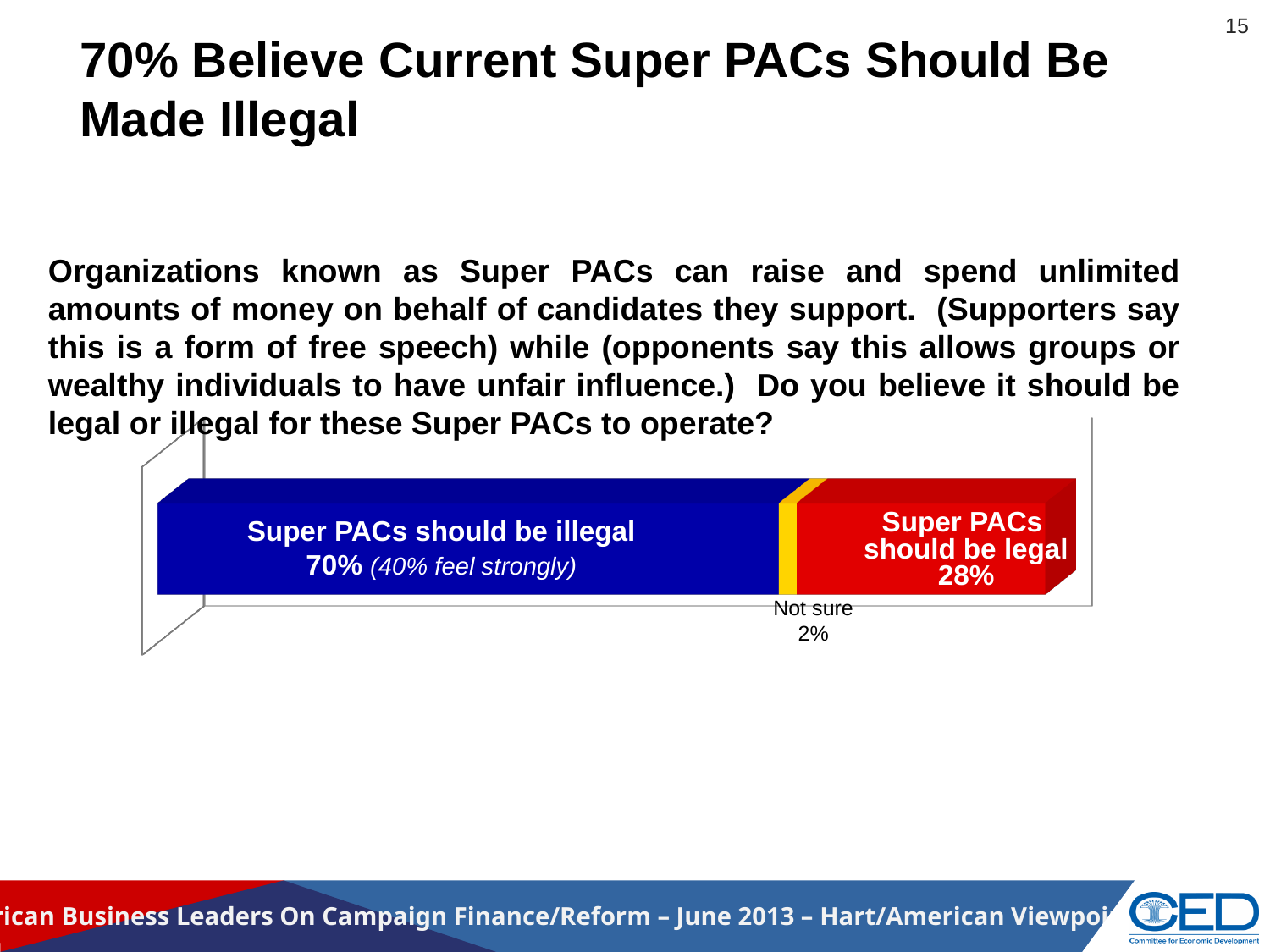
What is the total of the three segments in the stacked bar? 100% What kind of chart is shown on the slide? Stacked bar chart What percentage of respondents say Super PACs should be legal? 28% Which response has the smallest share? Not sure Which response has the largest share? Super PACs should be illegal What percentage of respondents are not sure? 2% How many response categories are shown in the bar? 3 What colour is the segment for 'Super PACs should be legal'? Red What is the difference between the share saying Super PACs should be illegal and the share saying they should be legal? 42 percentage points What percentage of respondents feel strongly that Super PACs should be illegal? 40% What percentage of respondents say Super PACs should be illegal? 70% Which is larger: the share saying Super PACs should be legal or the share that is not sure? Super PACs should be legal